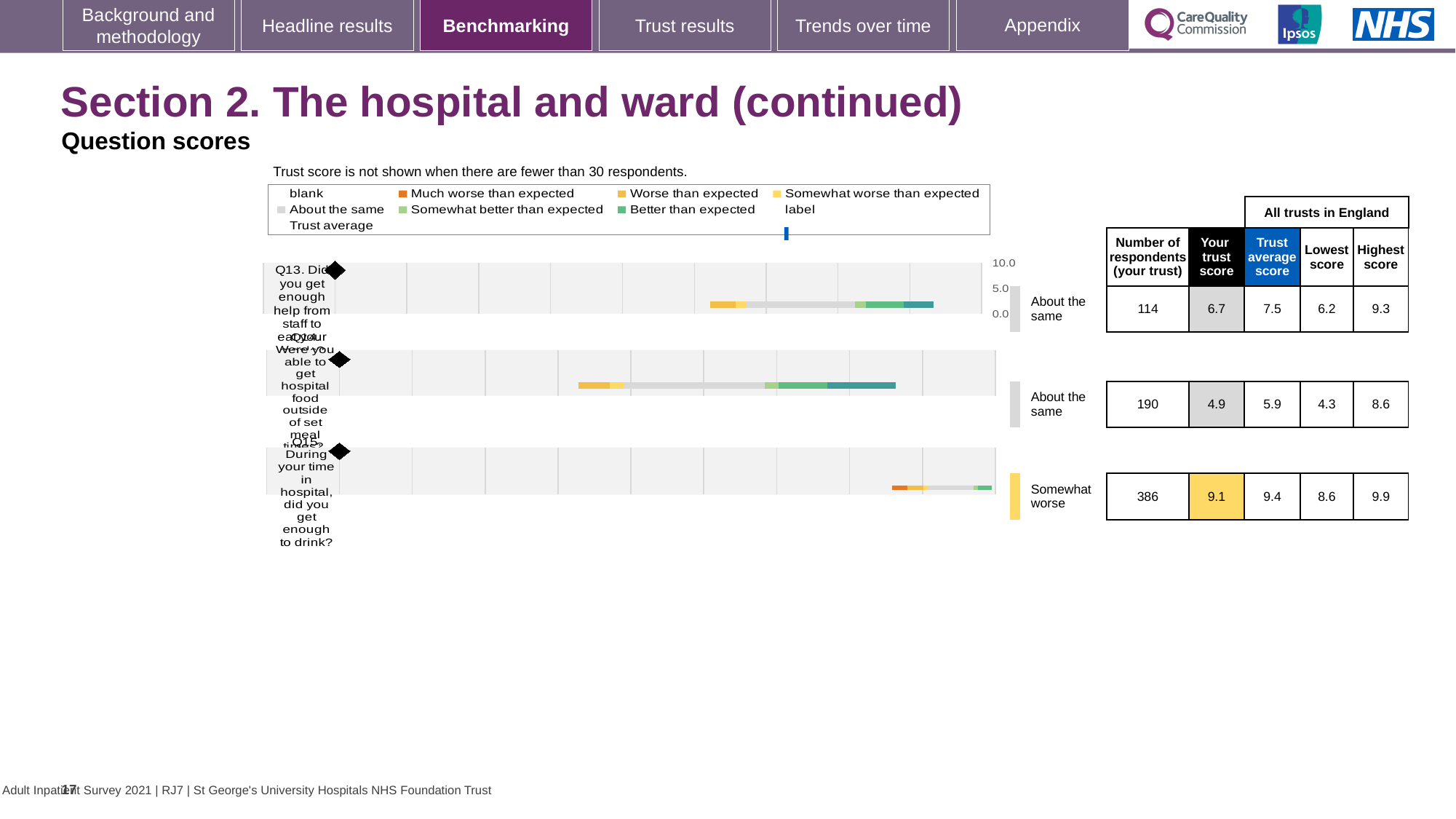
Which question has the highest 'Your trust score' on this slide? Q15 What is the lowest score among all trusts in England for Q14? 4.3 What is the 'Your trust score' for Q13 (Did you get enough help from staff to eat your meals?)? 6.7 How many respondents from your trust answered Q14 (Were you able to get hospital food outside of set meal times?)? 190 Which question has the lowest 'Your trust score' on this slide? Q14 How many questions are shown in the benchmarking charts on this slide? 3 For Q13, how much higher is the trust average score than your trust score? 0.8 For Q15, what is the difference between the highest score and the lowest score among all trusts in England? 1.3 What is the highest score among all trusts in England for Q15? 9.9 What benchmarking category is shown for Q15 on this slide? Somewhat worse What is the trust average score across all trusts in England for Q15 (did you get enough to drink?)? 9.4 For Q14, which is larger: your trust score or the trust average score? Trust average score